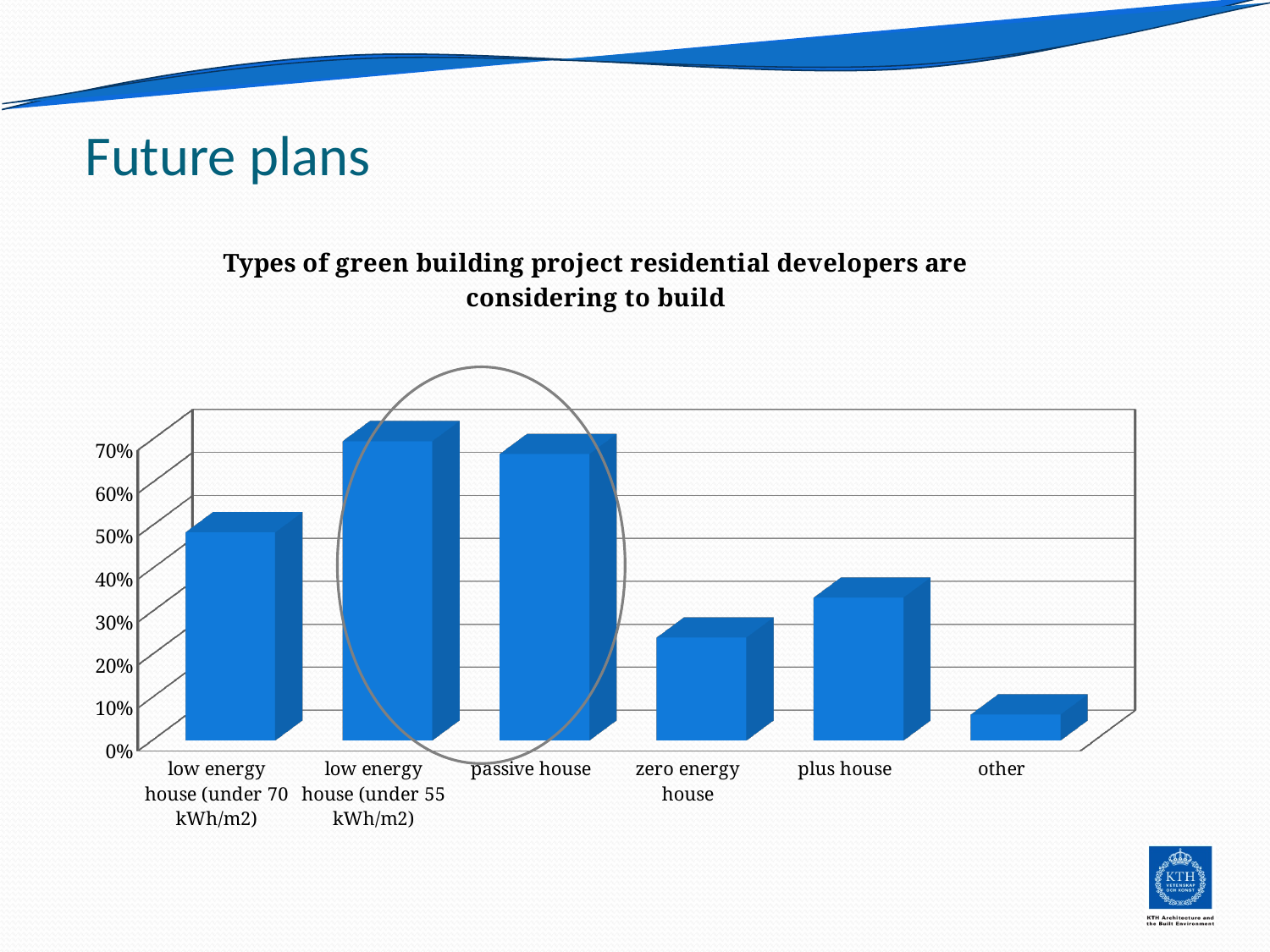
Is the value for other greater or less than 10%? less Is the value for plus house greater or less than 40%? less Which has a larger value, passive house or low energy house (under 70 kWh/m2)? passive house What type of chart is shown on the slide? bar chart How many categories are shown on the x axis of the chart? 6 Which has a larger value, plus house or zero energy house? plus house Which category has the highest value in the chart? low energy house (under 55 kWh/m2) What is the title of the chart? Types of green building project residential developers are considering to build Is the value for low energy house (under 70 kWh/m2) greater or less than 40%? greater Which category has the lowest value in the chart? other